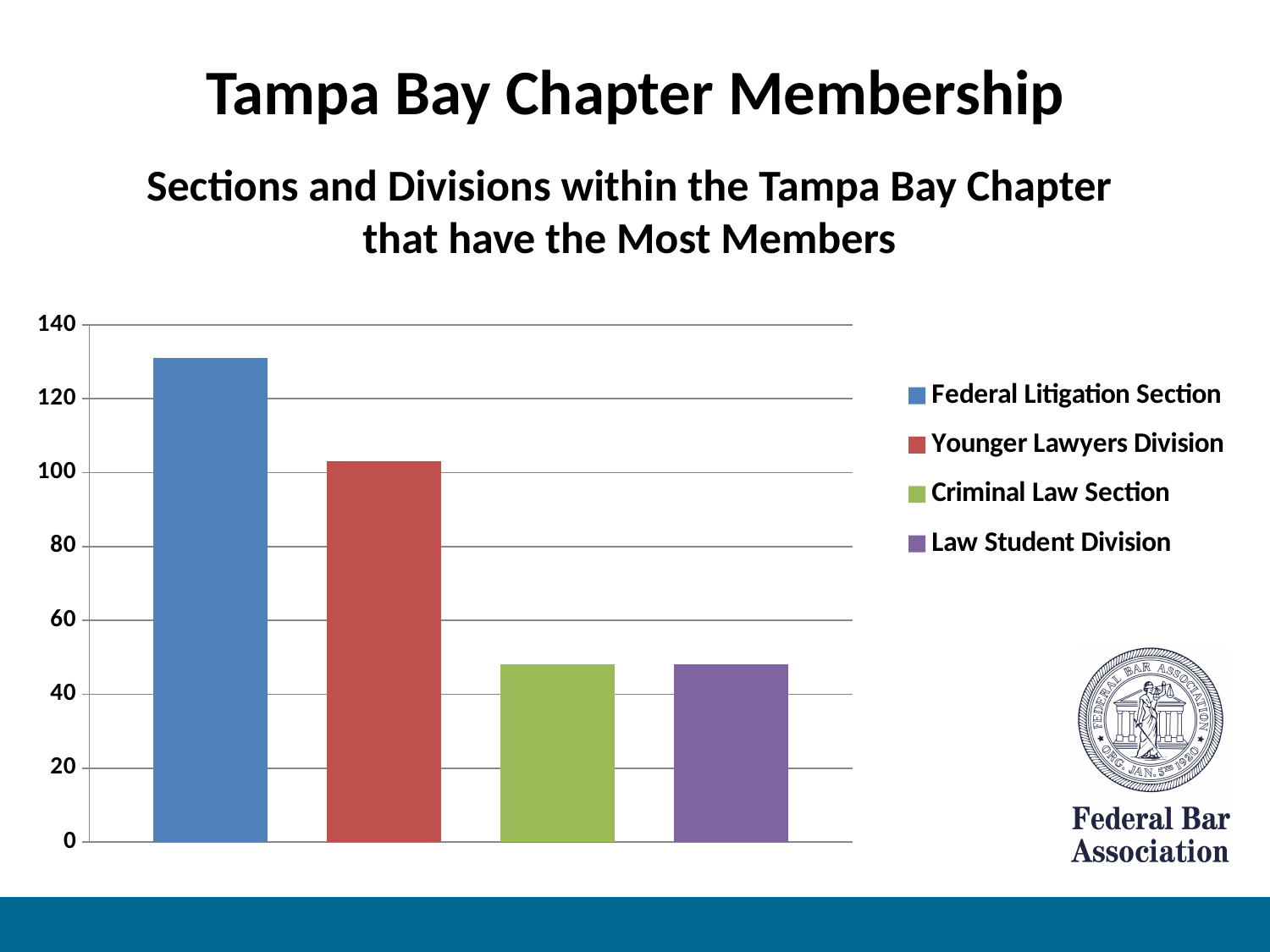
What colour is the bar for Law Student Division? purple What kind of chart is shown on the slide? bar chart How many sections or divisions are plotted in the chart? 4 How many entries does the legend list? 4 Which has more members, Federal Litigation Section or Younger Lawyers Division? Federal Litigation Section Is the value for Federal Litigation Section greater or less than 120? greater Do the bar values rise or fall from left to right across the chart? fall Is the value for Law Student Division greater or less than 40? greater Which has more members, Younger Lawyers Division or Criminal Law Section? Younger Lawyers Division Which section or division has the highest number of members? Federal Litigation Section Is the value for Criminal Law Section greater or less than 60? less